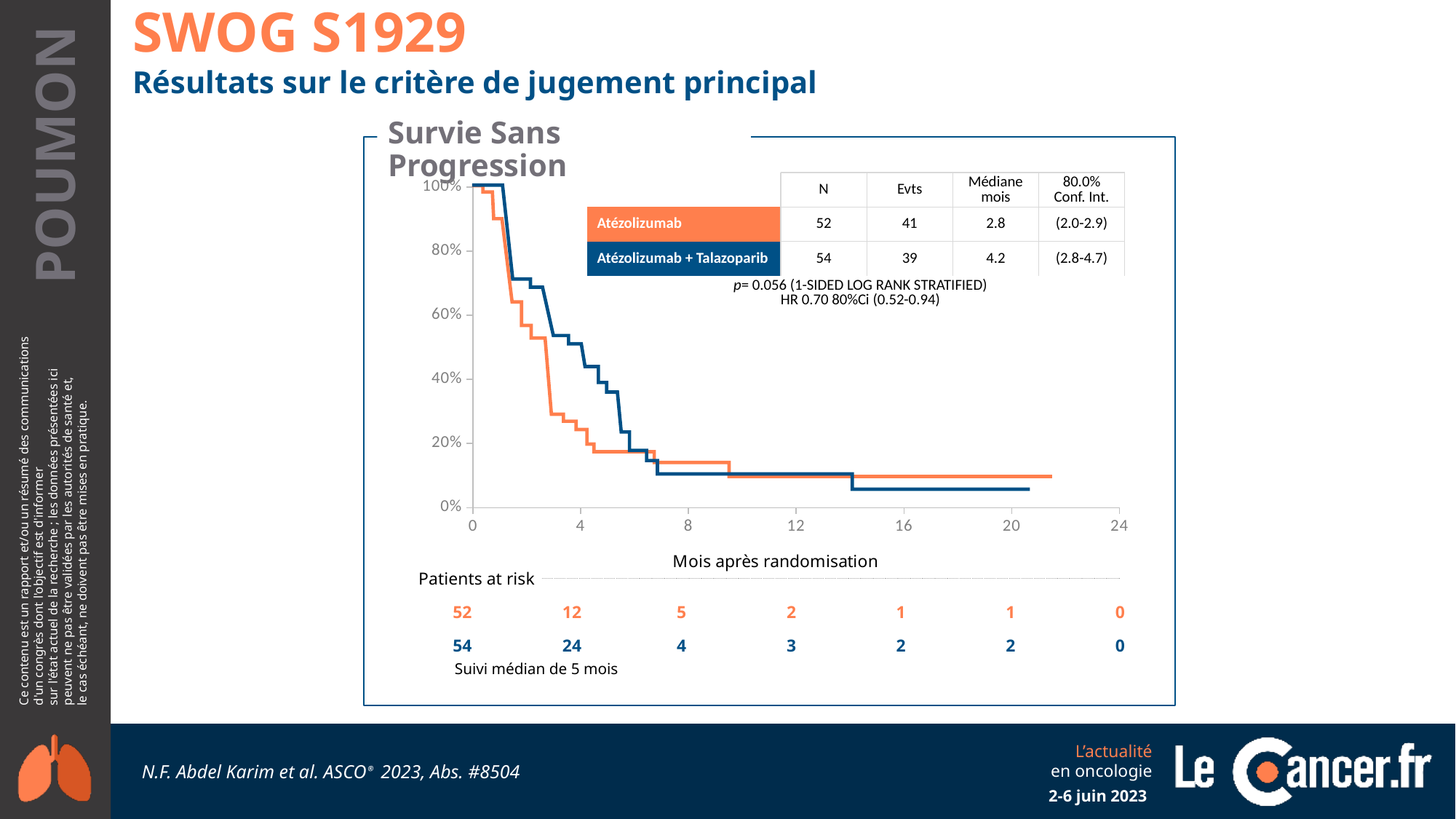
What is the hazard ratio (HR) reported on the chart? 0.70 How many treatment arms (series) are plotted on the progression-free survival chart? 2 At 4 months, is the progression-free survival for the Atézolizumab arm greater or less than 40%? less How many events (Evts) were recorded in the Atézolizumab + Talazoparib arm? 39 How many patients (N) were in the Atézolizumab arm? 52 What is the 80% confidence interval for the median in the Atézolizumab arm? (2.0-2.9) What is the median progression-free survival in months for the Atézolizumab arm? 2.8 Which arm has the higher median progression-free survival? Atézolizumab + Talazoparib What is the median progression-free survival in months for the Atézolizumab + Talazoparib arm? 4.2 How many patients were at risk at 4 months in the Atézolizumab + Talazoparib arm? 24 What kind of chart is shown on the slide? Line chart (Kaplan-Meier survival curve) What is the difference in median progression-free survival (months) between the Atézolizumab + Talazoparib arm and the Atézolizumab arm? 1.4